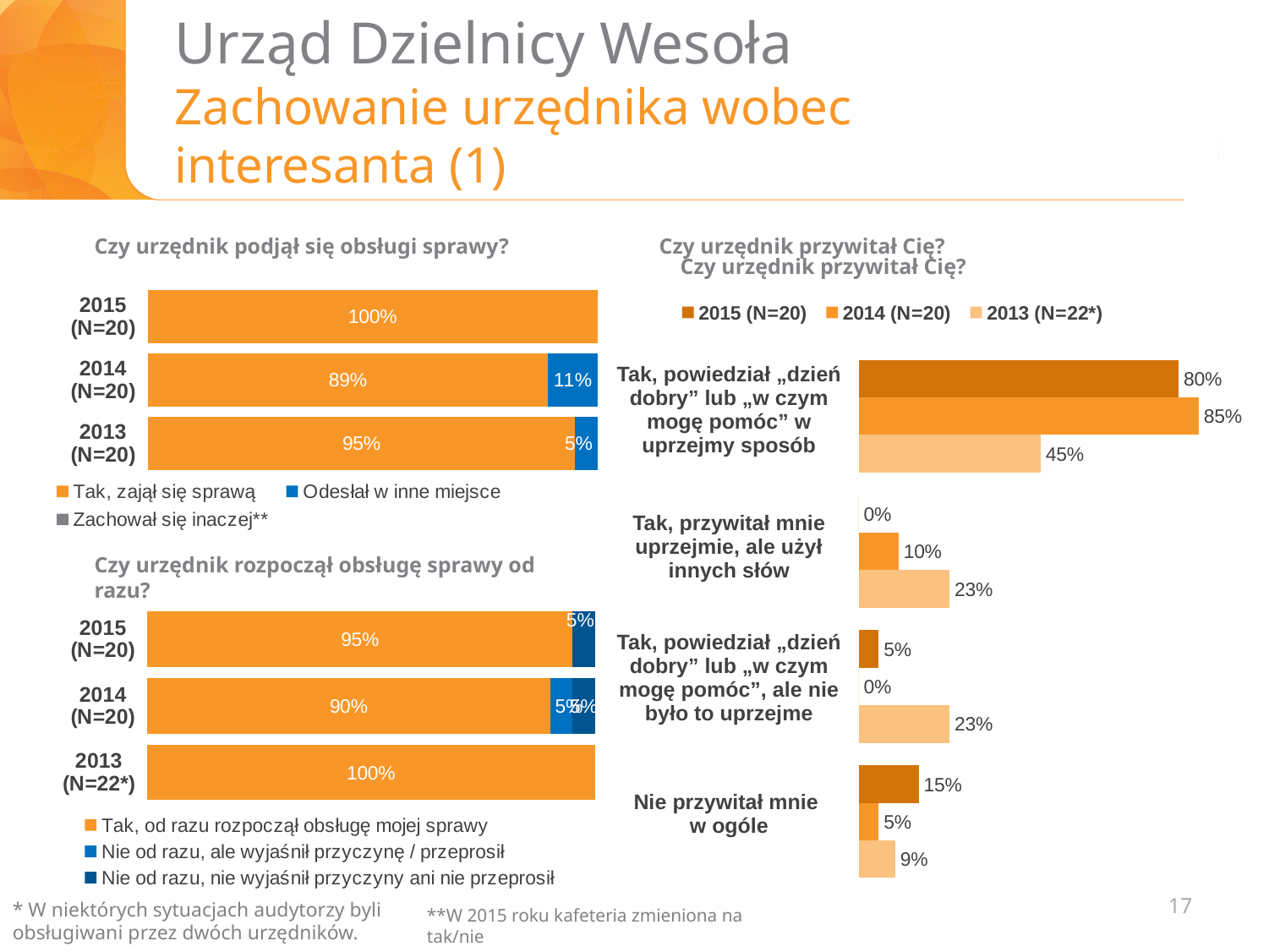
In the chart "Czy urzędnik przywitał Cię?", which series has the larger value for "Nie przywitał mnie w ogóle": 2015 (N=20) or 2014 (N=20)? 2015 (N=20) In the chart "Czy urzędnik podjął się obsługi sprawy?", how many entries does the legend list? 3 In the chart "Czy urzędnik rozpoczął obsługę sprawy od razu?", what percentage is shown for "Tak, od razu rozpoczął obsługę mojej sprawy" in 2015 (N=20)? 95% In the chart "Czy urzędnik podjął się obsługi sprawy?", what percentage is shown for "Odesłał w inne miejsce" in 2013 (N=20)? 5% In the chart "Czy urzędnik rozpoczął obsługę sprawy od razu?", which year shows 100% for "Tak, od razu rozpoczął obsługę mojej sprawy"? 2013 (N=22*) In the chart "Czy urzędnik przywitał Cię?", what is the 2014 (N=20) value for "Tak, powiedział „dzień dobry” lub „w czym mogę pomóc” w uprzejmy sposób"? 85% In the chart "Czy urzędnik przywitał Cię?", what is the difference between the 2014 (N=20) and 2013 (N=22*) values for "Tak, powiedział „dzień dobry” lub „w czym mogę pomóc” w uprzejmy sposób"? 40 percentage points In the chart "Czy urzędnik podjął się obsługi sprawy?", which year has the highest value for "Tak, zajął się sprawą"? 2015 (N=20) In the chart "Czy urzędnik podjął się obsługi sprawy?", what percentage is shown for "Tak, zajął się sprawą" in 2014 (N=20)? 89% In the chart "Czy urzędnik przywitał Cię?", how many answer categories are shown? 4 In the chart "Czy urzędnik przywitał Cię?", what is the 2013 (N=22*) value for "Nie przywitał mnie w ogóle"? 9% In the chart "Czy urzędnik rozpoczął obsługę sprawy od razu?", what kind of chart is used? Stacked bar chart